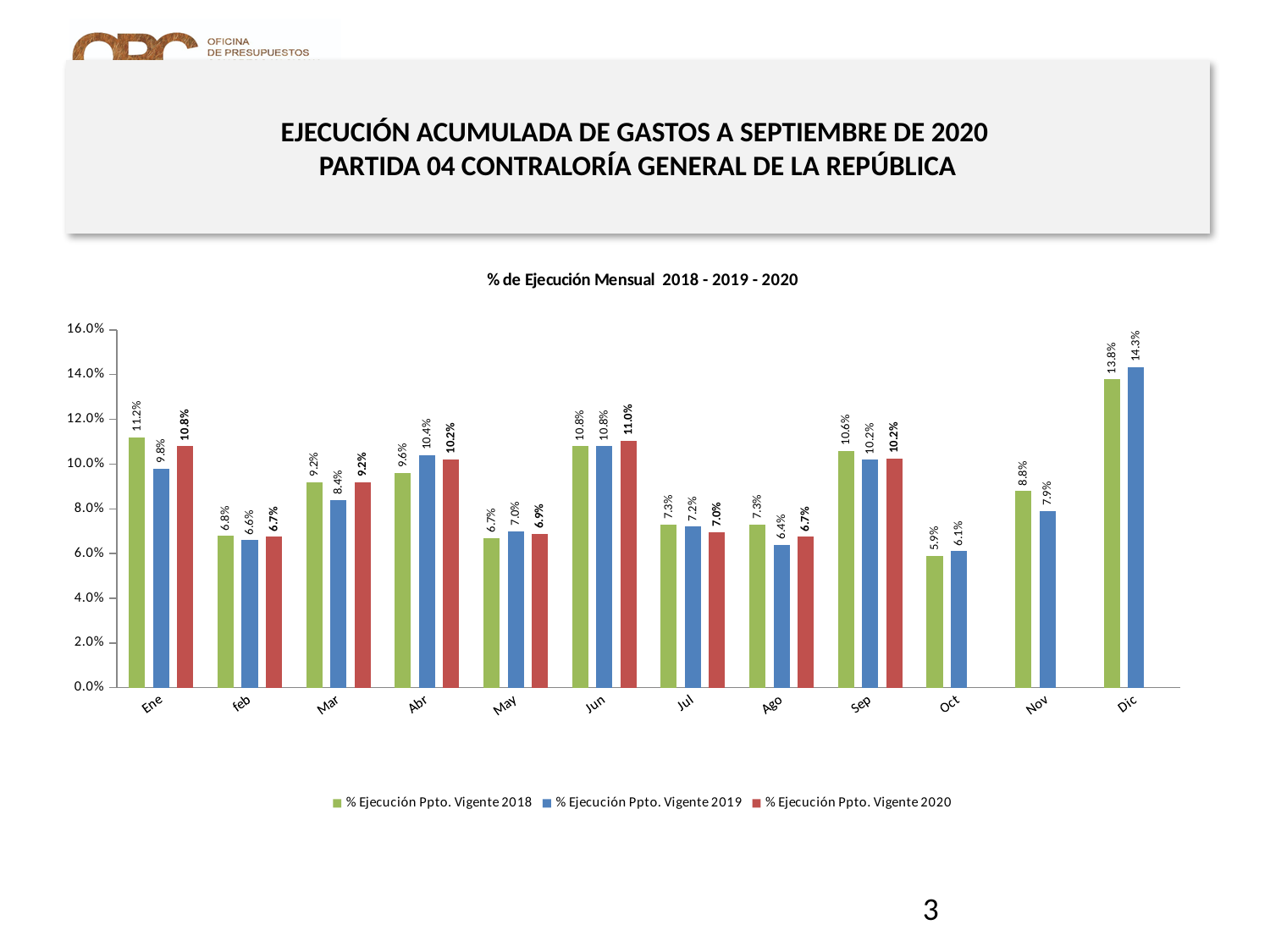
How many series does the legend list? 3 Which colour represents % Ejecución Ppto. Vigente 2020 in the chart? Red Which month has the lowest value for % Ejecución Ppto. Vigente 2018? Oct How many months are shown on the x axis? 12 What kind of chart is shown on the slide? Bar chart Which month has the highest value for % Ejecución Ppto. Vigente 2019? Dic What is the value for % Ejecución Ppto. Vigente 2019 in Abr? 10.4% In Ago, which is larger: the 2018 value or the 2019 value? 2018 (7.3%) What is the difference between the 2018 and 2019 values in Ene? 1.4 percentage points What is the value for % Ejecución Ppto. Vigente 2020 in Ene? 10.8% Is the value for % Ejecución Ppto. Vigente 2019 in Dic greater or less than 14.0%? greater What is the value for % Ejecución Ppto. Vigente 2018 in Nov? 8.8%